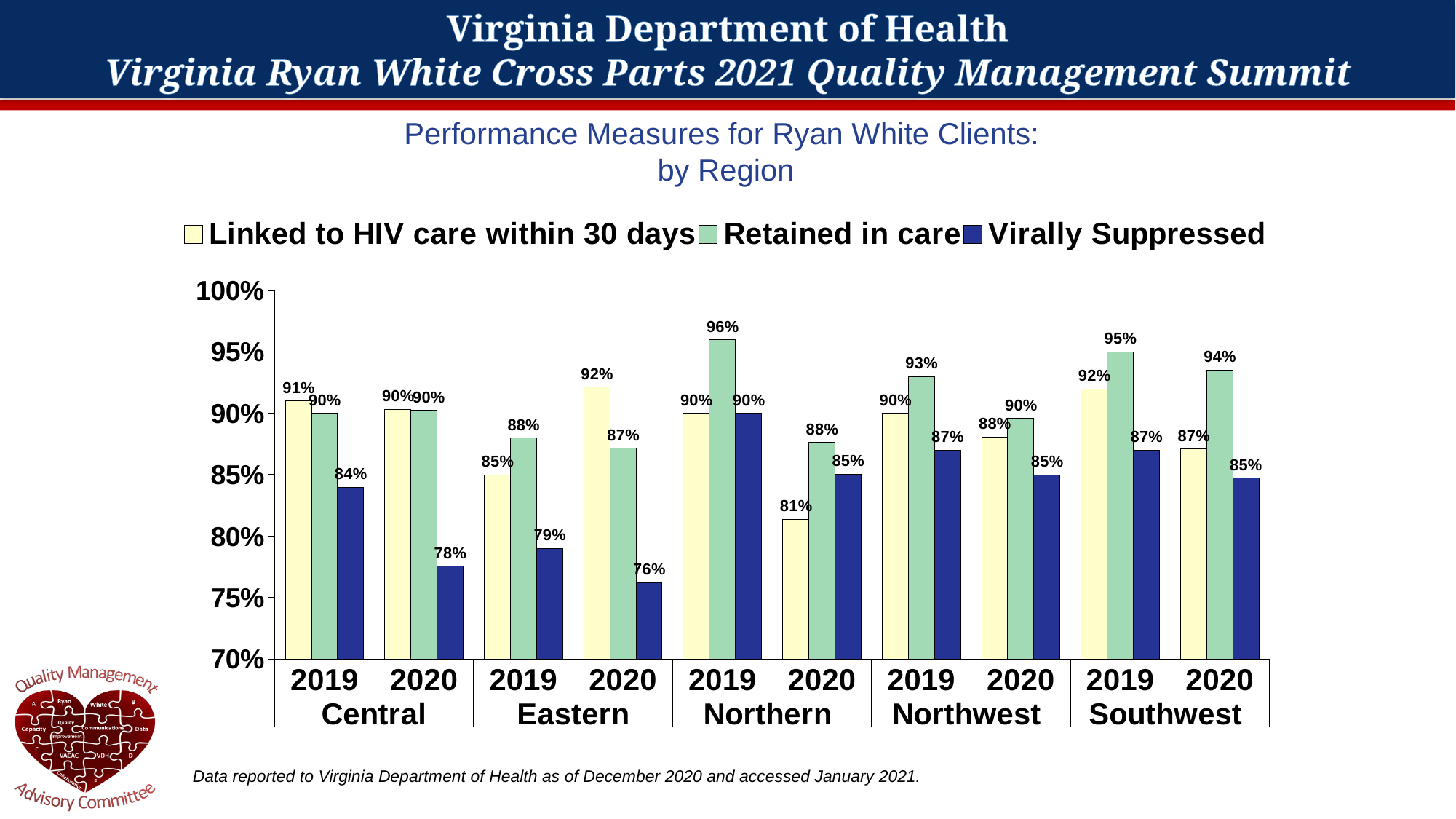
Which is larger: the Linked to HIV care within 30 days value for Eastern in 2019 or in 2020? 2020 How many regions are shown on the x axis? 5 What is the difference between the Virally Suppressed values for Central in 2019 and 2020? 6% What kind of chart is shown on the slide? bar chart Which region and year has the highest Retained in care value? Northern 2019 Did the Linked to HIV care within 30 days value for Northern rise or fall from 2019 to 2020? fall Which region and year has the lowest Virally Suppressed value? Eastern 2020 How many series does the legend list? 3 What is the Virally Suppressed value for Northern in 2019? 90% What is the Retained in care value for Southwest in 2020? 94% What is the Linked to HIV care within 30 days value for Northern in 2020? 81% Is the Virally Suppressed value for Eastern in 2020 greater or less than 80%? less